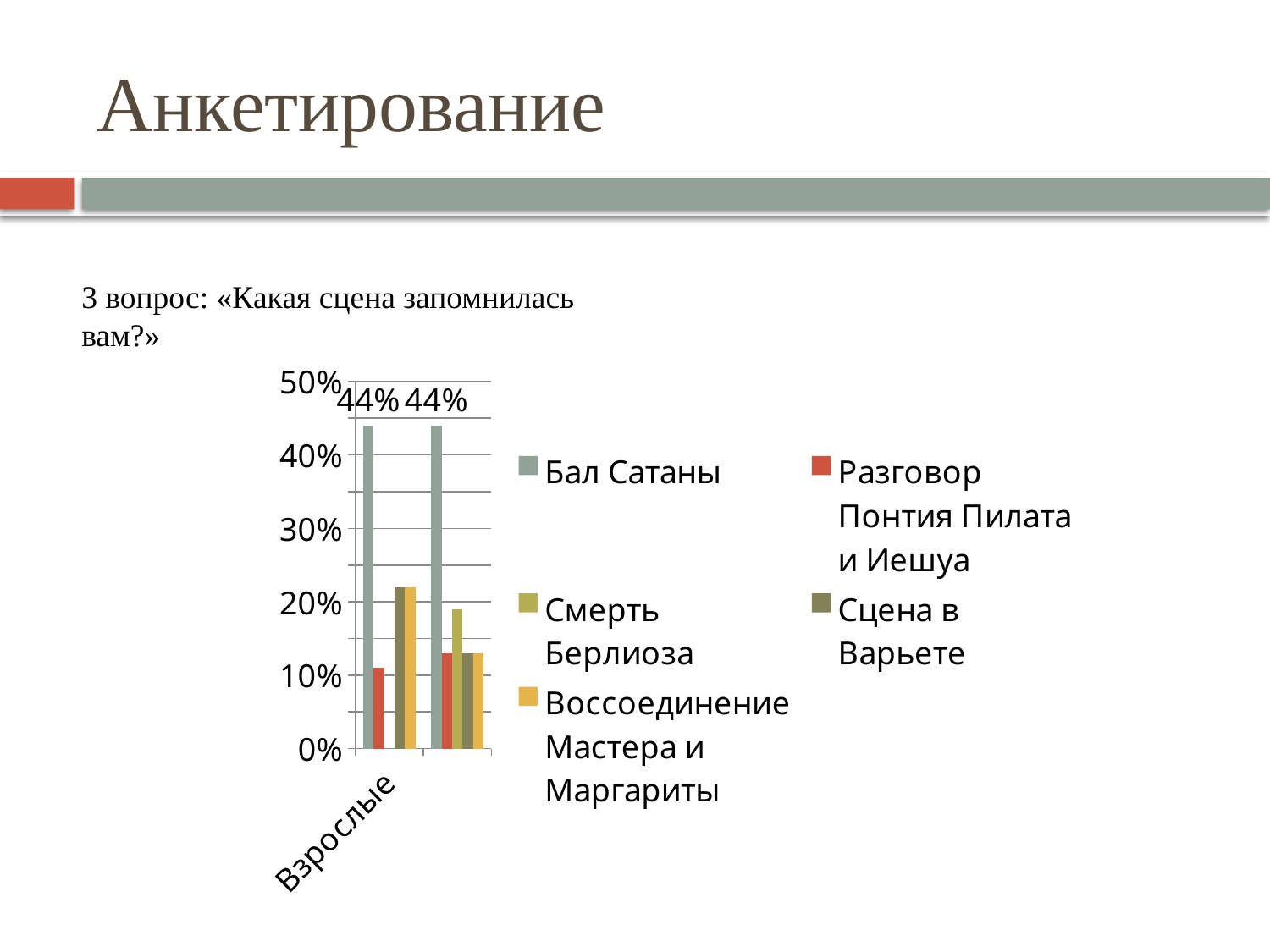
Is the value for Сцена в Варьете in the Взрослые group greater or less than 30%? less Is the value for Бал Сатаны in the Взрослые group greater or less than 40%? greater What survey question does the chart illustrate? Какая сцена запомнилась вам? What is the value for Бал Сатаны in the Взрослые group? 44% Is the value for Разговор Понтия Пилата и Иешуа in the Взрослые group greater or less than 20%? less How many series does the legend list? 5 Which series has the highest value in the Взрослые group? Бал Сатаны What kind of chart is shown on the slide? bar chart Which is larger for Взрослые: Бал Сатаны or Разговор Понтия Пилата и Иешуа? Бал Сатаны Which series is shown in grey in the legend? Бал Сатаны